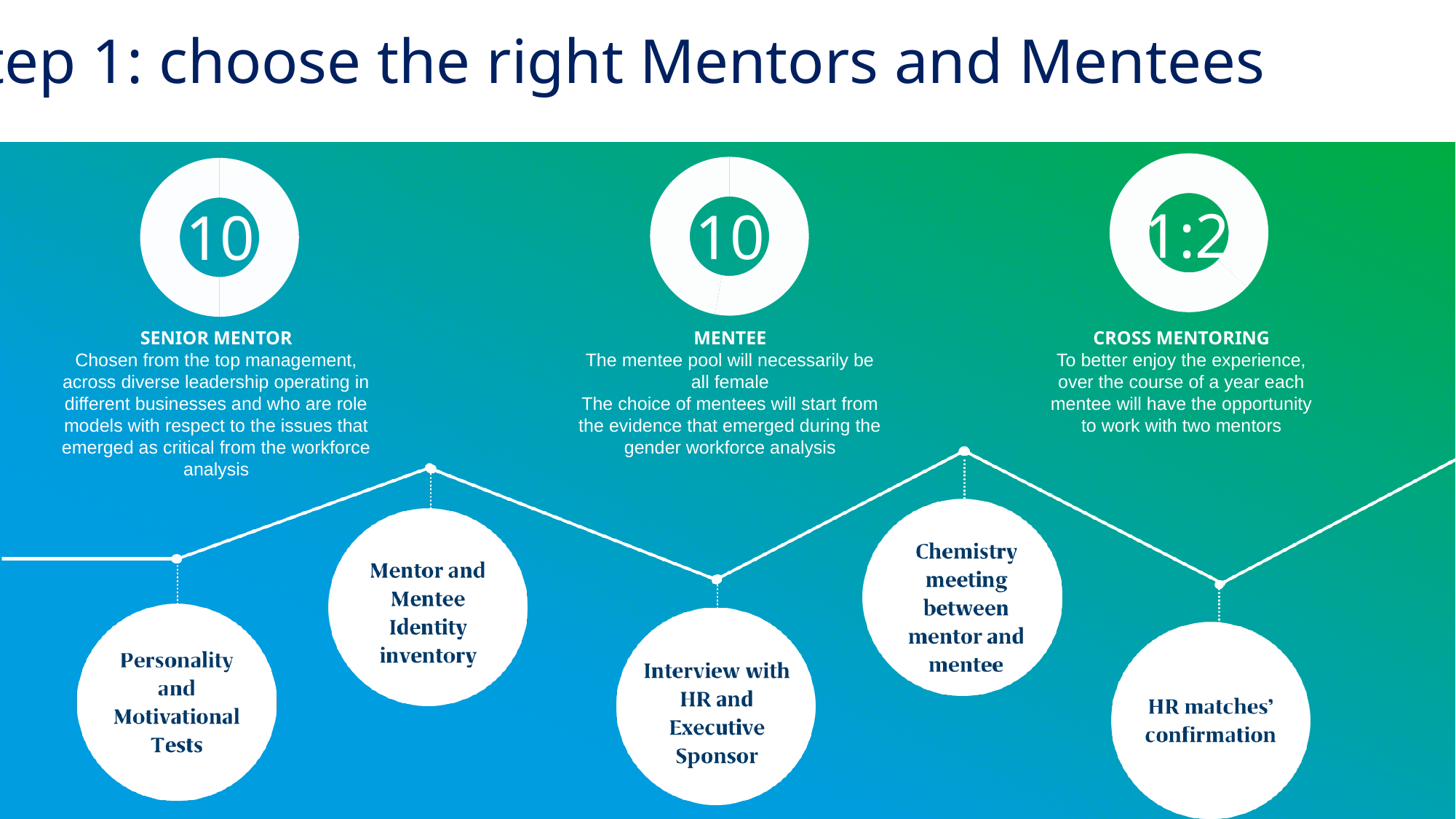
What number is shown in the circle labelled SENIOR MENTOR? 10 How many process steps are shown in the circles along the timeline at the bottom of the slide? 5 Which label appears under the leftmost circular chart? SENIOR MENTOR What kind of chart are the three circles at the top of the slide? doughnut chart What value is shown in the circle labelled CROSS MENTORING? 1:2 How many circular charts are shown across the top of the slide? 3 What number is shown in the circle labelled MENTEE? 10 Which label appears under the rightmost circular chart? CROSS MENTORING